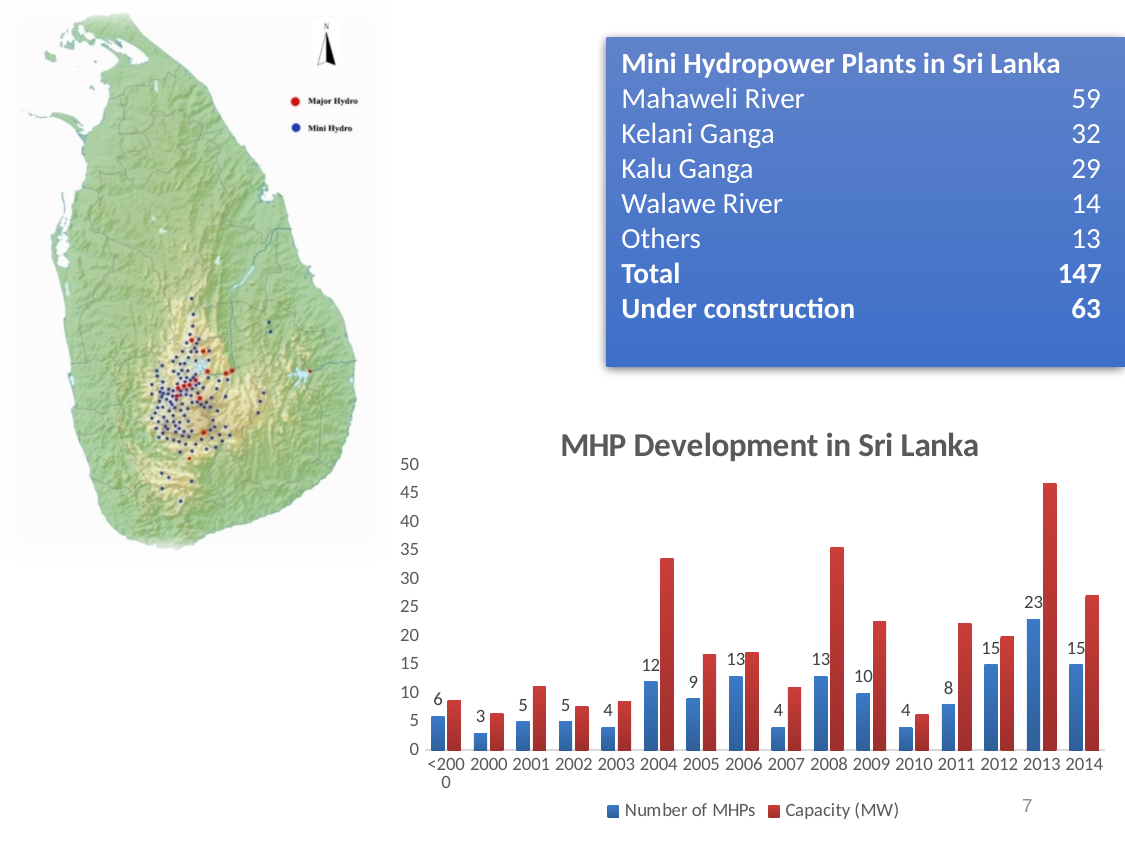
In the MHP Development in Sri Lanka chart, what is the Number of MHPs for 2004? 12 In the MHP Development in Sri Lanka chart, which year has a larger Number of MHPs, 2005 or 2006? 2006 How many year categories are shown on the x axis of the MHP Development in Sri Lanka chart? 16 In the MHP Development in Sri Lanka chart, which year has the highest Number of MHPs? 2013 What kind of chart is the MHP Development in Sri Lanka chart? bar chart In the MHP Development in Sri Lanka chart, is the Capacity (MW) for 2013 greater or less than 40? greater How many series does the legend of the MHP Development in Sri Lanka chart list? 2 In the MHP Development in Sri Lanka chart, which year has the highest Capacity (MW)? 2013 In the MHP Development in Sri Lanka chart, is the Capacity (MW) for 2004 greater or less than 30? greater In the MHP Development in Sri Lanka chart, which year has the lowest Number of MHPs? 2000 In the MHP Development in Sri Lanka chart, what is the difference between the Number of MHPs in 2013 and in 2012? 8 In the MHP Development in Sri Lanka chart, what is the Number of MHPs for 2013? 23